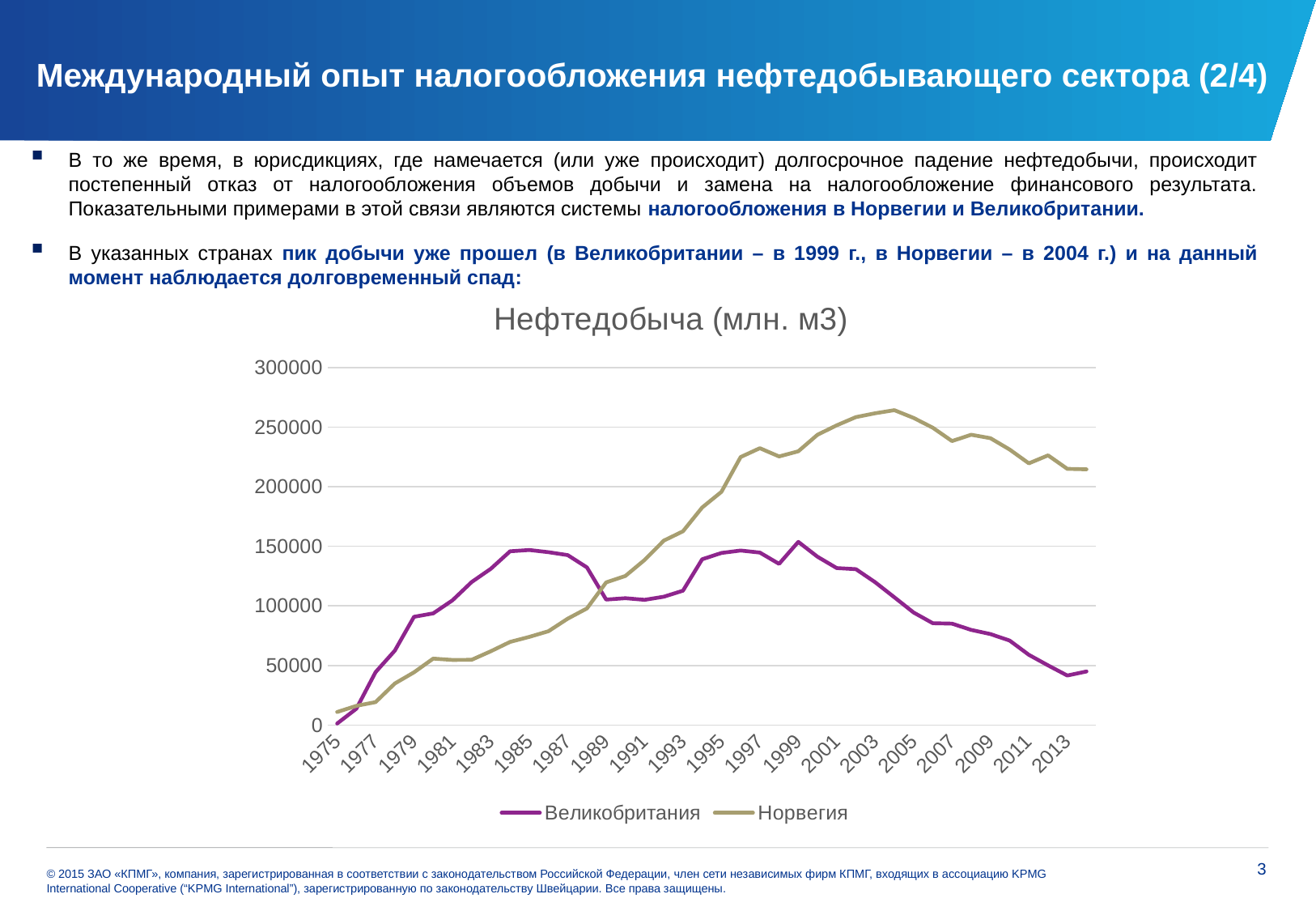
Is the value for Великобритания in 2013 greater or less than 50000? less What is the title of the chart? Нефтедобыча (млн. м3) Is the value for Великобритания in 2009 greater or less than 100000? less In 1985, which series has the higher value, Великобритания or Норвегия? Великобритания How many series does the chart legend list? 2 Is the value for Норвегия in 2013 greater or less than 200000? greater Which series is drawn in purple on the chart? Великобритания What kind of chart is shown on the slide? line chart In which year does the line for Великобритания reach its highest point? 1999 Does the line for Великобритания rise or fall between 1999 and 2013? fall In which year does the line for Норвегия reach its highest point? 2004